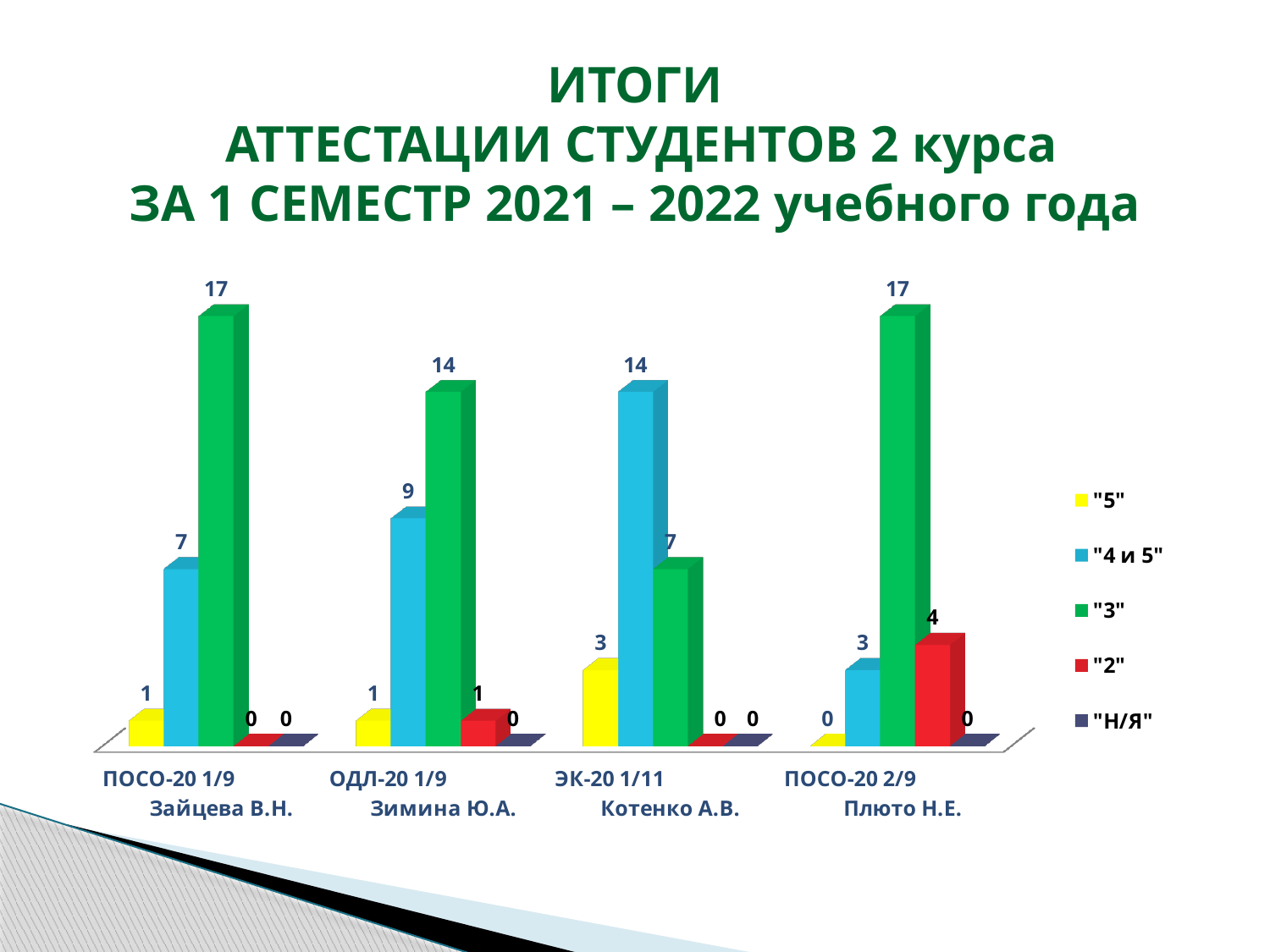
What is the value of the "3" series for ПОСО-20 1/9 (Зайцева В.Н.)? 17 What is the value of the "4 и 5" series for ЭК-20 1/11 (Котенко А.В.)? 14 What kind of chart is shown on the slide? bar chart What is the difference between the "3" value and the "4 и 5" value for ПОСО-20 1/9 (Зайцева В.Н.)? 10 Which group has the lowest value for the "3" series? ЭК-20 1/11 (Котенко А.В.) How many series does the legend list? 5 What colour represents the "2" series in the legend? red Which is larger for ОДЛ-20 1/9 (Зимина Ю.А.): the "4 и 5" value or the "3" value? "3" Which group has the highest value for the "4 и 5" series? ЭК-20 1/11 (Котенко А.В.) How many groups (categories) are shown on the x axis? 4 What is the value of the "2" series for ПОСО-20 2/9 (Плюто Н.Е.)? 4 What is the value of the "5" series for ОДЛ-20 1/9 (Зимина Ю.А.)? 1